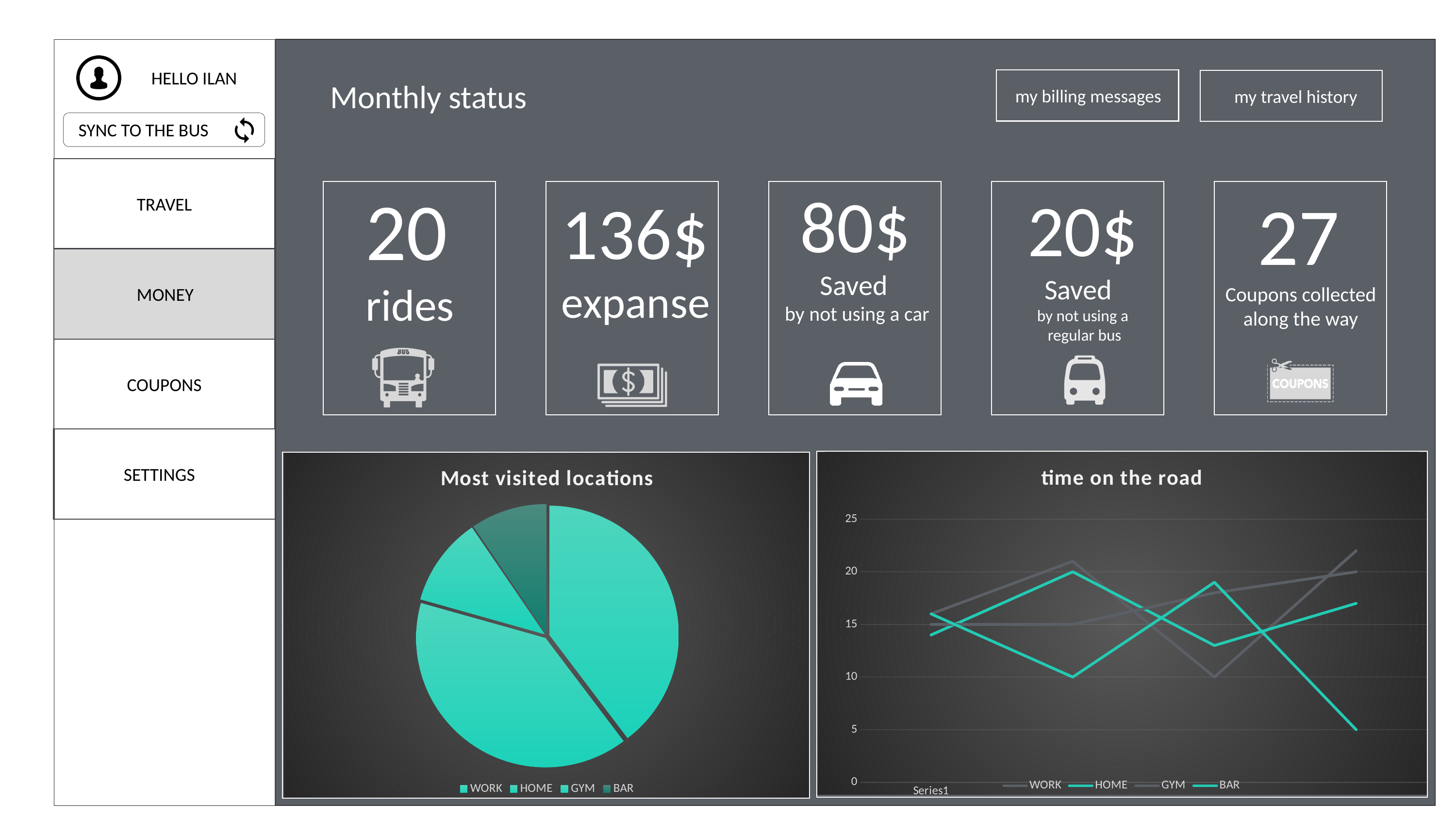
In the "Most visited locations" pie chart, which slice is larger, HOME or GYM? HOME How many slices does the "Most visited locations" pie chart have? 4 What kind of chart is "time on the road"? line chart In the "time on the road" chart, is the highest plotted value greater or less than 25? less In the "Most visited locations" pie chart, which slice is larger, WORK or BAR? WORK In the "Most visited locations" pie chart, which category has the smallest slice? BAR What is the highest tick value shown on the vertical axis of the "time on the road" chart? 25 How many entries does the legend of the "Most visited locations" chart list? 4 What kind of chart is "Most visited locations"? pie chart How many series does the legend of the "time on the road" chart list? 4 What are the legend entries of the "Most visited locations" chart? WORK, HOME, GYM, BAR How many data points does each line have in the "time on the road" chart? 4